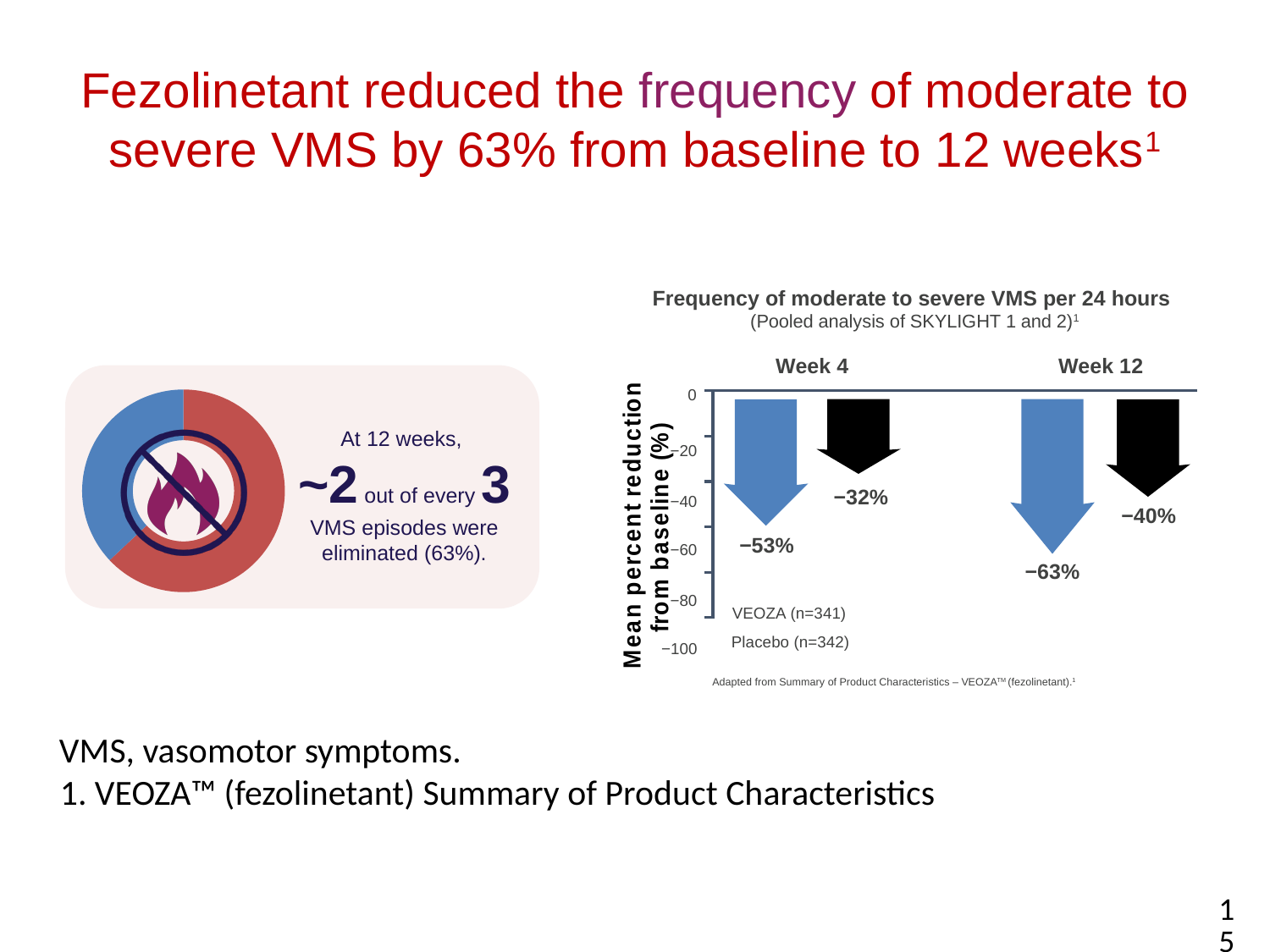
In the chart titled 'Frequency of moderate to severe VMS per 24 hours', which shows a larger reduction from baseline at Week 4: VEOZA or Placebo? VEOZA In the chart titled 'Frequency of moderate to severe VMS per 24 hours', how many series does the legend list? 2 In the chart titled 'Frequency of moderate to severe VMS per 24 hours', what is the mean percent reduction from baseline for VEOZA at Week 4? −53% In the chart titled 'Frequency of moderate to severe VMS per 24 hours', how many time points are shown on the x axis? 2 In the chart titled 'Frequency of moderate to severe VMS per 24 hours', what is the mean percent reduction from baseline for Placebo at Week 12? −40% In the chart titled 'Frequency of moderate to severe VMS per 24 hours', by how many percentage points does the VEOZA reduction exceed the Placebo reduction at Week 12? 23 percentage points In the chart titled 'Frequency of moderate to severe VMS per 24 hours', which series and time point shows the smallest percent reduction from baseline? Placebo at Week 4 In the chart titled 'Frequency of moderate to severe VMS per 24 hours', what is the label of the y axis? Mean percent reduction from baseline (%) In the chart titled 'Frequency of moderate to severe VMS per 24 hours', by how many percentage points does the VEOZA reduction exceed the Placebo reduction at Week 4? 21 percentage points In the chart titled 'Frequency of moderate to severe VMS per 24 hours', which series and time point shows the largest percent reduction from baseline? VEOZA at Week 12 In the chart titled 'Frequency of moderate to severe VMS per 24 hours', what is the mean percent reduction from baseline for VEOZA at Week 12? −63% In the chart titled 'Frequency of moderate to severe VMS per 24 hours', what is the mean percent reduction from baseline for Placebo at Week 4? −32%